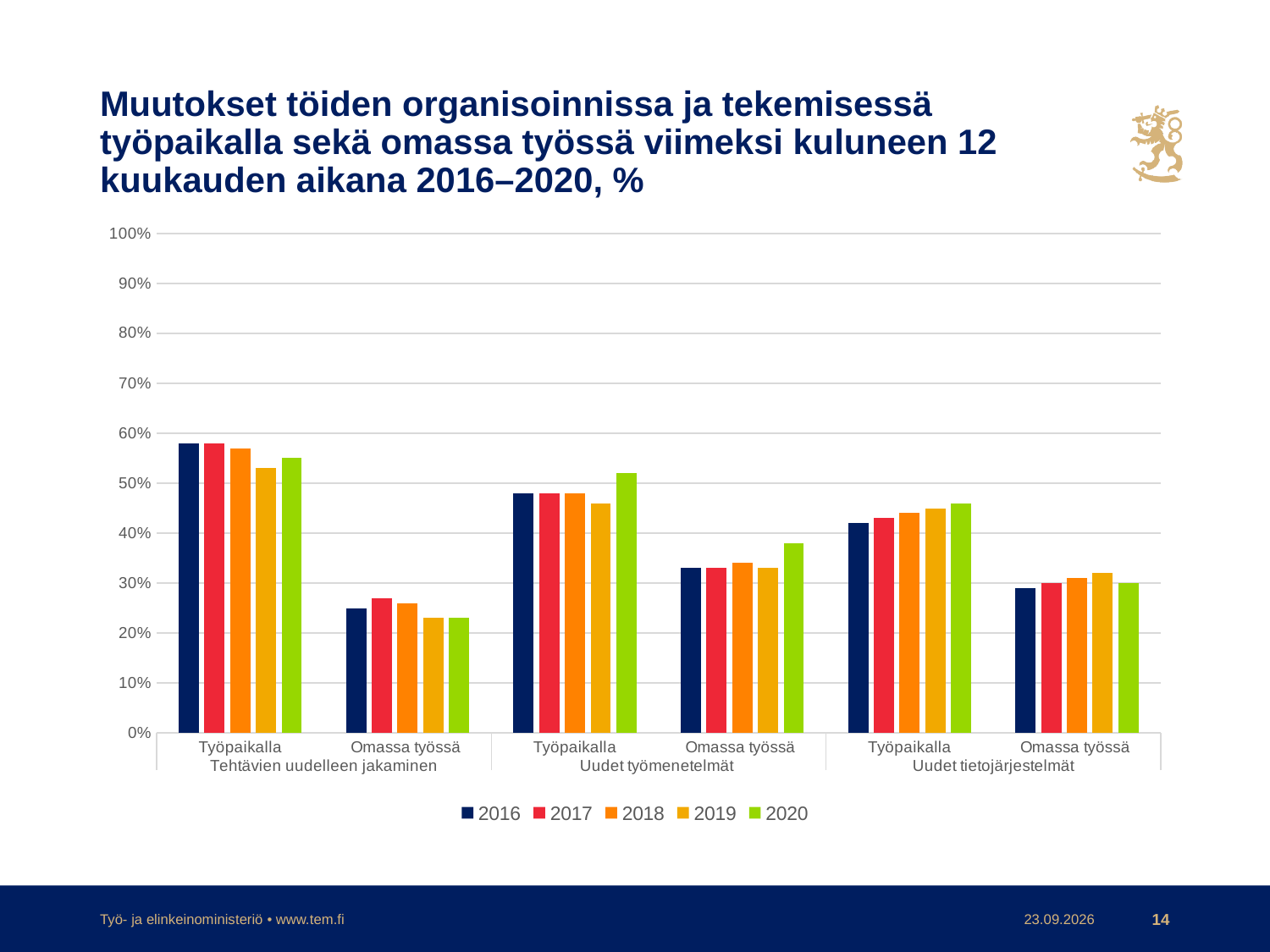
How many main category groups (Tehtävien uudelleen jakaminen, Uudet työmenetelmät, Uudet tietojärjestelmät) are shown along the x axis? 3 Under Uudet työmenetelmät, Omassa työssä, which is larger: the 2016 value or the 2020 value? 2020 Under Uudet työmenetelmät, Työpaikalla, which year has the highest value? 2020 Is the 2016 value for Omassa työssä under Uudet tietojärjestelmät greater or less than 40%? less Is the 2020 value for Omassa työssä under Tehtävien uudelleen jakaminen greater or less than 30%? less What kind of chart is shown on the slide? Bar chart Under Uudet tietojärjestelmät, Työpaikalla, do the values rise or fall from 2016 to 2020? rise What colour represents the 2020 series in the legend? Green How many series does the legend list? 5 Is the 2020 value for Työpaikalla under Uudet työmenetelmät greater or less than 50%? greater Under Tehtävien uudelleen jakaminen, which has the larger 2016 value: Työpaikalla or Omassa työssä? Työpaikalla